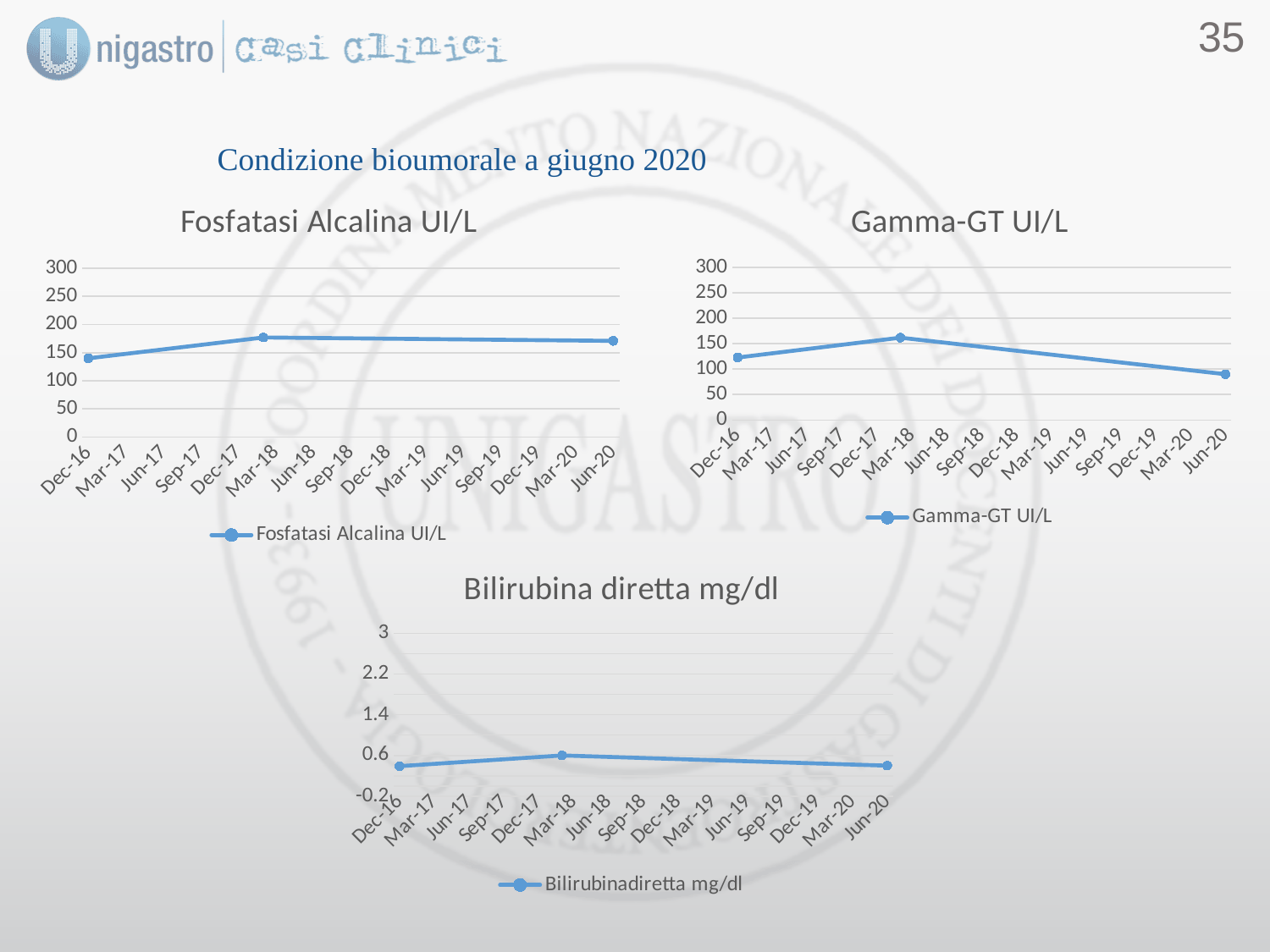
What kind of chart is the Fosfatasi Alcalina UI/L chart? line chart In the Fosfatasi Alcalina UI/L chart, at which date is the value lowest? Dec-16 In the Bilirubina diretta mg/dl chart, is the value for Mar-18 greater or less than 1.4? less In the Gamma-GT UI/L chart, at which date is the value lowest? Jun-20 In the Gamma-GT UI/L chart, is the value for Jun-20 greater or less than 100? less In the Gamma-GT UI/L chart, which is larger, the value for Dec-16 or the value for Jun-20? Dec-16 What is the title of the chart at the bottom of the slide? Bilirubina diretta mg/dl In the Gamma-GT UI/L chart, how many data points are plotted on the line? 3 In the Gamma-GT UI/L chart, does the value rise or fall between Mar-18 and Jun-20? fall In the Fosfatasi Alcalina UI/L chart, is the value for Mar-18 greater or less than 150? greater How many series does the legend of the Gamma-GT UI/L chart list? 1 In the Fosfatasi Alcalina UI/L chart, at which date is the value highest? Mar-18